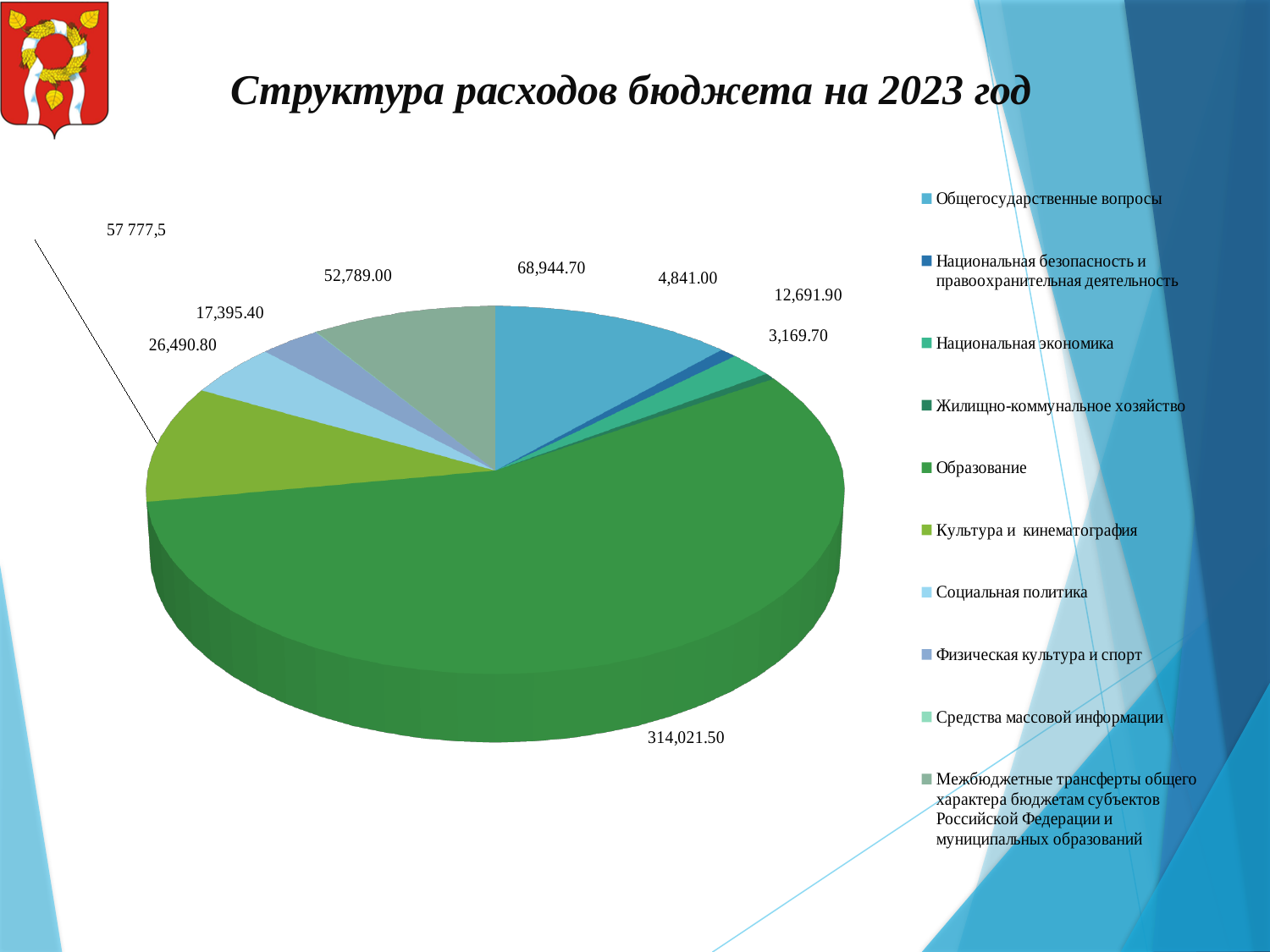
What is the smallest value labelled on the pie chart? 3,169.70 What is the value shown for Образование? 314,021.50 Which is larger, the value for Общегосударственные вопросы or the value for Национальная безопасность и правоохранительная деятельность? Общегосударственные вопросы Which category has the largest slice of the pie? Образование What is the title of the chart? Структура расходов бюджета на 2023 год What kind of chart is shown on the slide? pie chart What is the value shown for Национальная экономика? 12,691.90 Which is larger, the value for Социальная политика or the value for Физическая культура и спорт? Социальная политика What is the difference between the value for Общегосударственные вопросы and the value for Национальная безопасность и правоохранительная деятельность? 64,103.70 How many entries does the chart legend list? 10 What is the value shown for Общегосударственные вопросы? 68,944.70 What is the value shown for Национальная безопасность и правоохранительная деятельность? 4,841.00